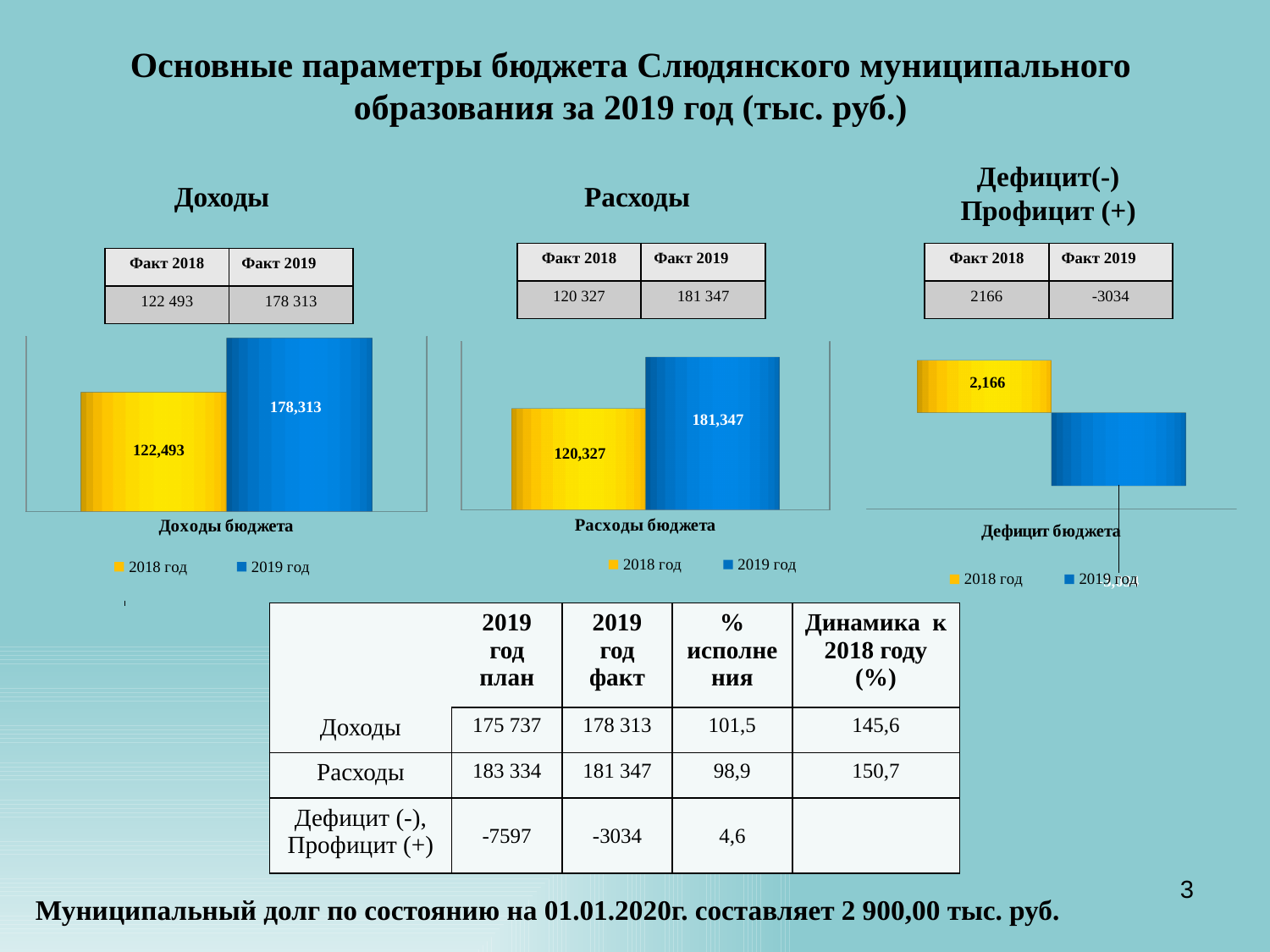
In the "Дефицит(-) Профицит (+)" chart, what is the value for 2018 год? 2,166 In the "Расходы" chart, which year has the lower value? 2018 год In the "Доходы" chart, what is the difference between the 2019 год and 2018 год values? 55,820 What type of chart is the "Доходы" chart? bar chart In the "Доходы" chart, which year has the higher value? 2019 год In the "Доходы" chart, what is the value for 2019 год? 178,313 In the "Расходы" chart, what is the value for 2019 год? 181,347 In the "Дефицит(-) Профицит (+)" chart, is the 2019 год bar above or below zero? below In the "Расходы" chart, what is the difference between the 2019 год and 2018 год values? 61,020 In the "Расходы" chart, what is the value for 2018 год? 120,327 How many series does the legend of the "Расходы" chart list? 2 In the "Доходы" chart, what is the value for 2018 год? 122,493